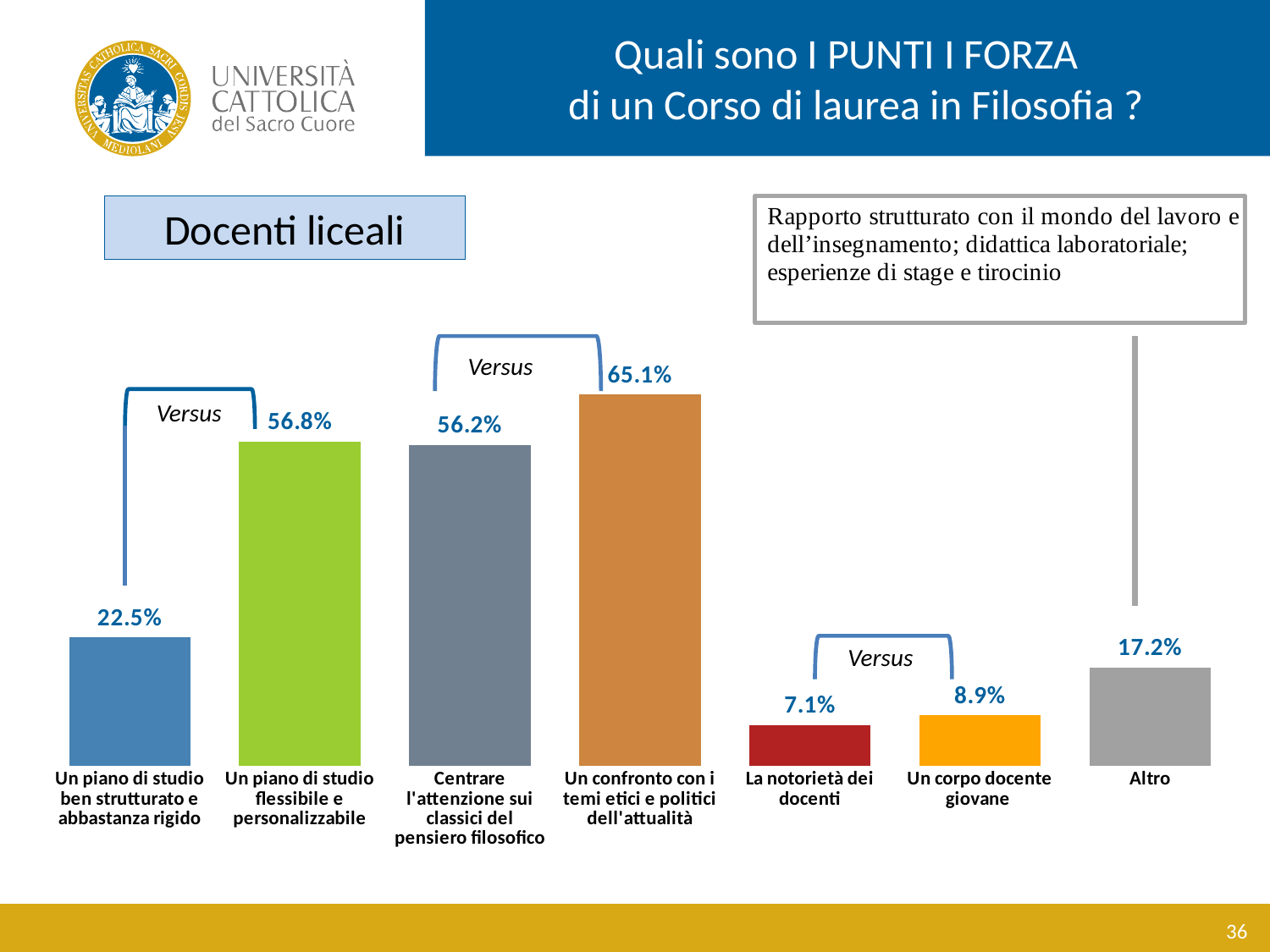
Which category has the highest value? Un confronto con i temi etici e politici dell'attualità What is the difference between "Un corpo docente giovane" and "La notorietà dei docenti"? 1.8% Which group of respondents does the chart refer to, according to the label box on the left? Docenti liceali What is the difference between "Un piano di studio flessibile e personalizzabile" and "Un piano di studio ben strutturato e abbastanza rigido"? 34.3% What kind of chart is shown on the slide? Bar chart What is the value for "Un confronto con i temi etici e politici dell'attualità"? 65.1% Which category has the lowest value? La notorietà dei docenti Which is larger: "Centrare l'attenzione sui classici del pensiero filosofico" or "Un confronto con i temi etici e politici dell'attualità"? Un confronto con i temi etici e politici dell'attualità How many categories are shown in the chart? 7 What is the value for "Un piano di studio ben strutturato e abbastanza rigido"? 22.5% What is the value for "Altro"? 17.2% Which is larger: "Altro" or "Un corpo docente giovane"? Altro